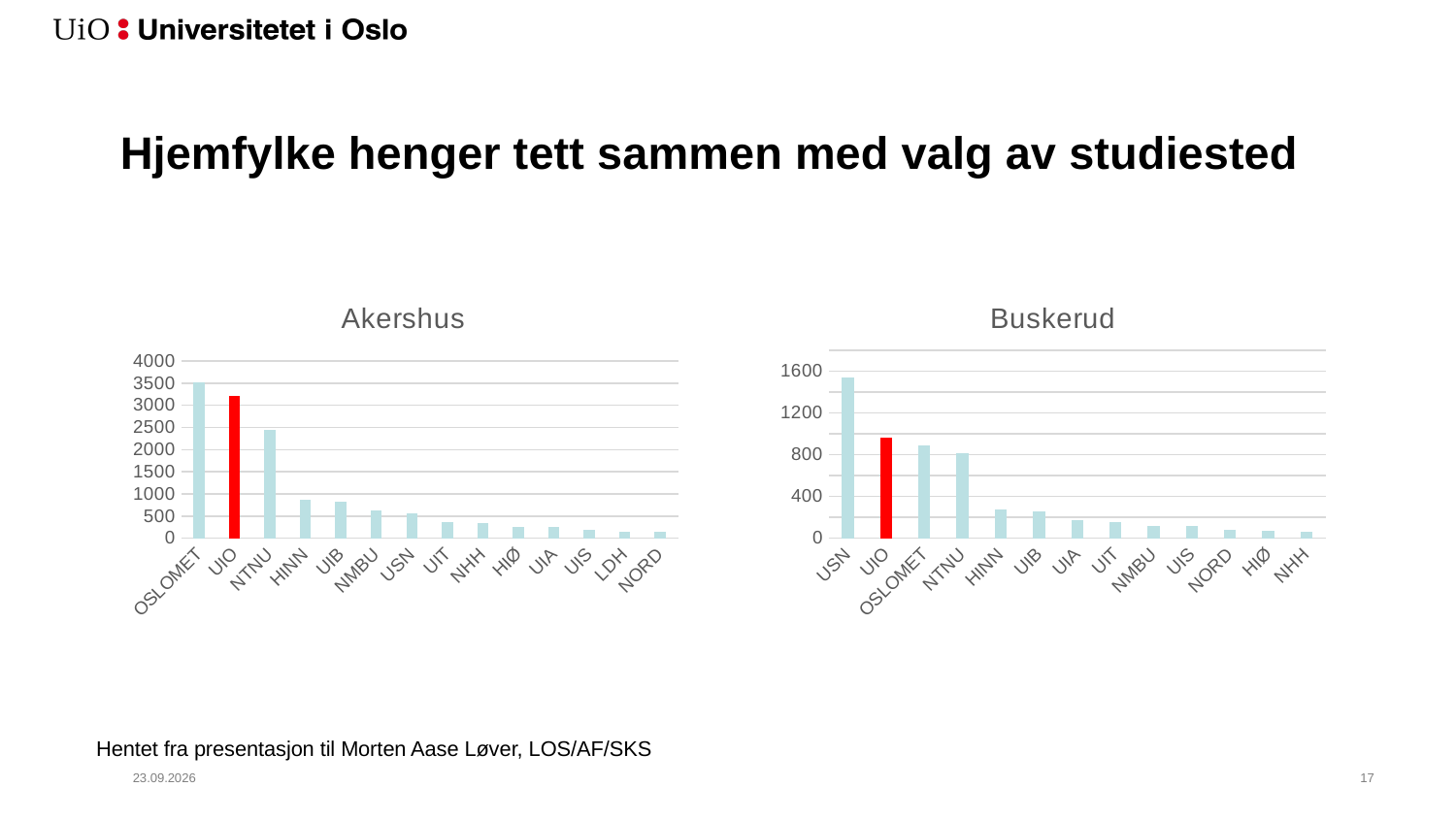
In the Akershus chart, is the value for NTNU greater or less than 3000? less In the Akershus chart, which institution has the highest value? OSLOMET In the Akershus chart, which bar is coloured red? UIO In the Akershus chart, which is larger, the value for UIO or the value for NTNU? UIO In the Buskerud chart, which is larger, the value for NTNU or the value for HINN? NTNU In the Buskerud chart, which institution has the highest value? USN In the Buskerud chart, is the value for HINN greater or less than 400? less In the Buskerud chart, is the value for USN greater or less than 1200? greater How many institutions are shown in the Akershus chart? 14 How many institutions are shown in the Buskerud chart? 13 What kind of chart is the Buskerud chart? Bar chart